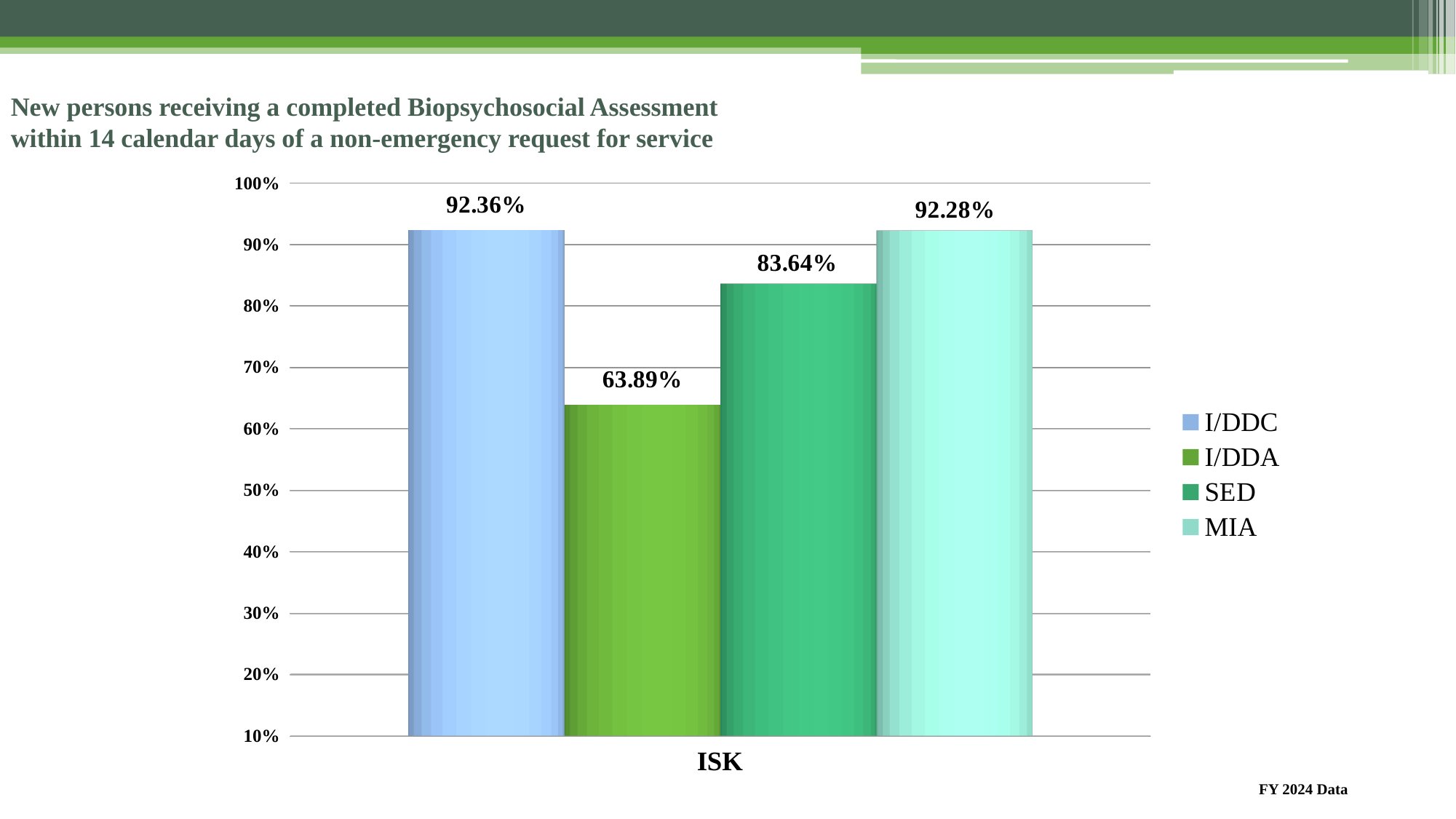
What is the value for SED? 83.64% Which series has the highest value? I/DDC What is the difference between the I/DDC value and the I/DDA value? 28.47 percentage points What kind of chart is shown on the slide? Bar chart What is the value for I/DDA? 63.89% Which is larger, the value for SED or the value for I/DDA? SED What is the value for I/DDC? 92.36% What is the value for MIA? 92.28% Which series has the lowest value? I/DDA How many series does the legend list? 4 Is the value for SED greater or less than 80%? greater What is the difference between the MIA value and the SED value? 8.64 percentage points